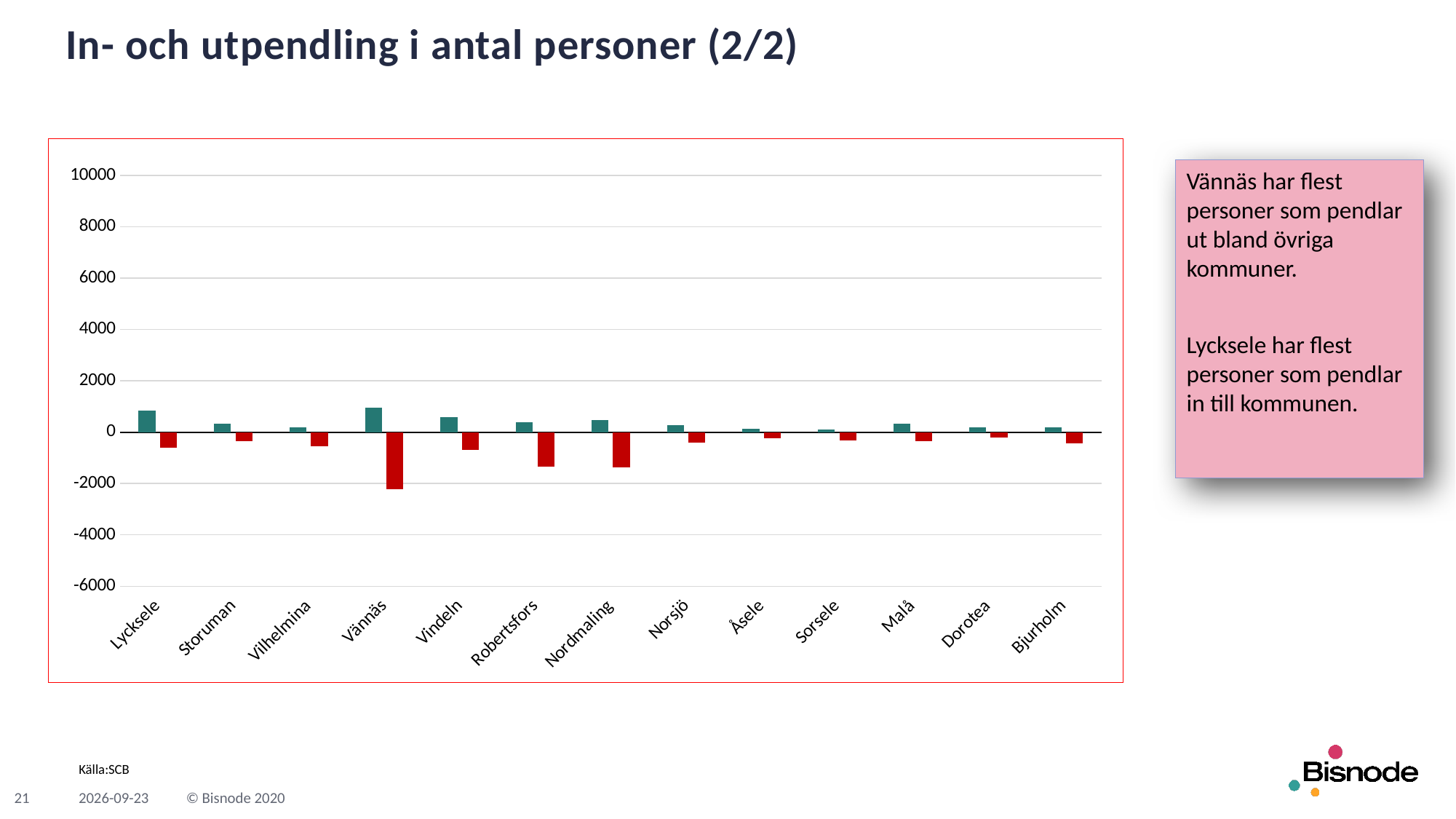
Which has the larger teal bar, Lycksele or Storuman? Lycksele What is the highest value shown on the chart's y axis? 10000 Which has the more negative red bar, Robertsfors or Storuman? Robertsfors How many municipalities are shown on the x axis of the chart? 13 Is the teal bar for Vännäs greater or less than 0? greater Is the red bar for Vännäs greater or less than -2000? less Which municipality has the lowest (most negative) red bar in the chart? Vännäs What kind of chart is shown on the slide? bar chart Is the red bar for Robertsfors greater or less than -2000? greater What is the title of the slide containing the chart? In- och utpendling i antal personer (2/2) Which has the larger teal bar, Vindeln or Sorsele? Vindeln